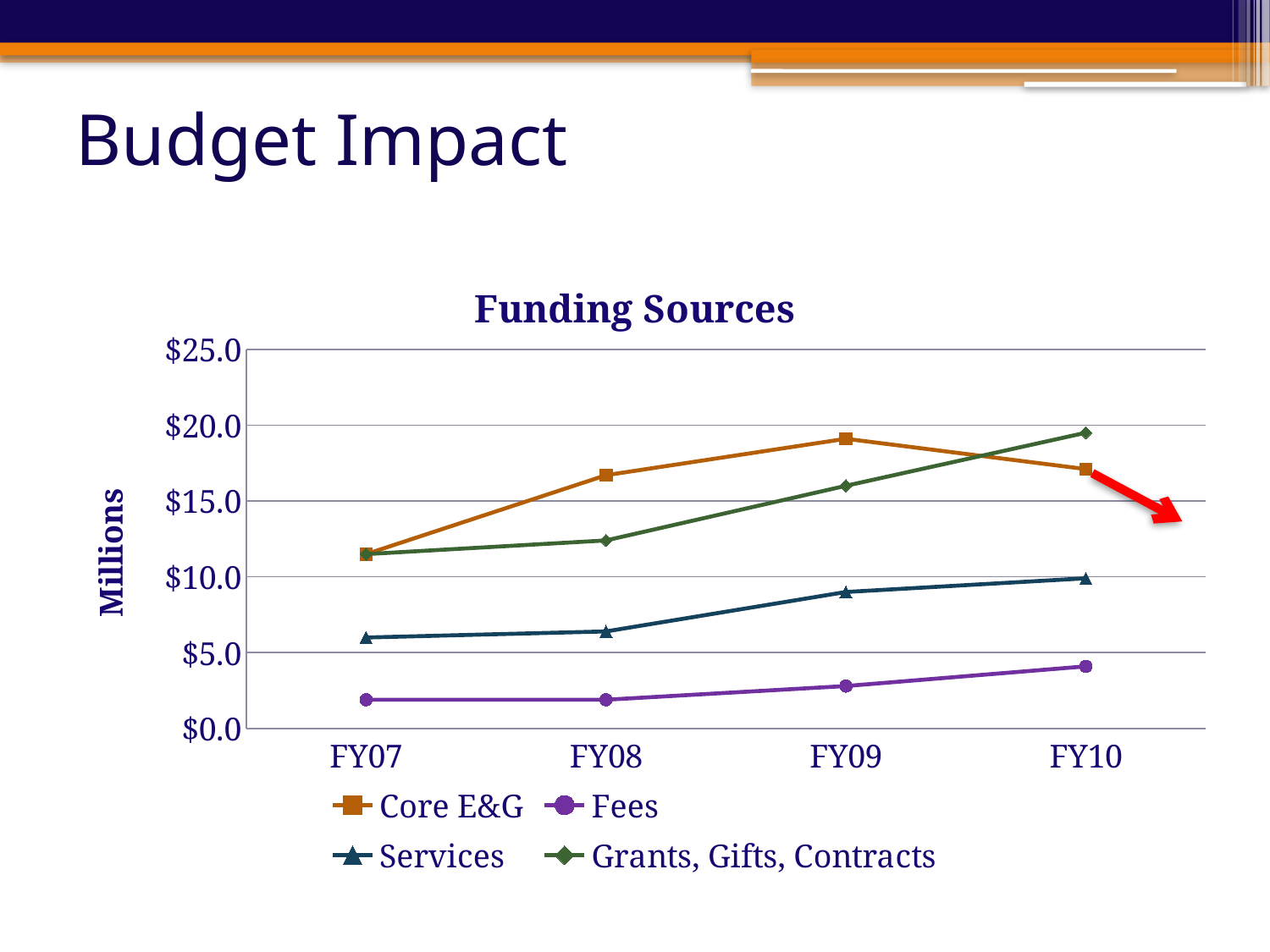
Does the Grants, Gifts, Contracts line rise or fall from FY07 to FY10? rise Is the value for Grants, Gifts, Contracts in FY08 greater or less than $10.0? greater In FY08, which is larger: Core E&G or Grants, Gifts, Contracts? Core E&G In FY10, which is larger: Core E&G or Grants, Gifts, Contracts? Grants, Gifts, Contracts How many series does the legend of the Funding Sources chart list? 4 Is the value for Services in FY09 greater or less than $10.0? less Is the value for Fees in FY10 greater or less than $5.0? less What kind of chart is shown on the slide? line chart What is the label on the vertical axis of the chart? Millions Which series has the lowest values across all fiscal years? Fees How many fiscal years are plotted along the x axis of the Funding Sources chart? 4